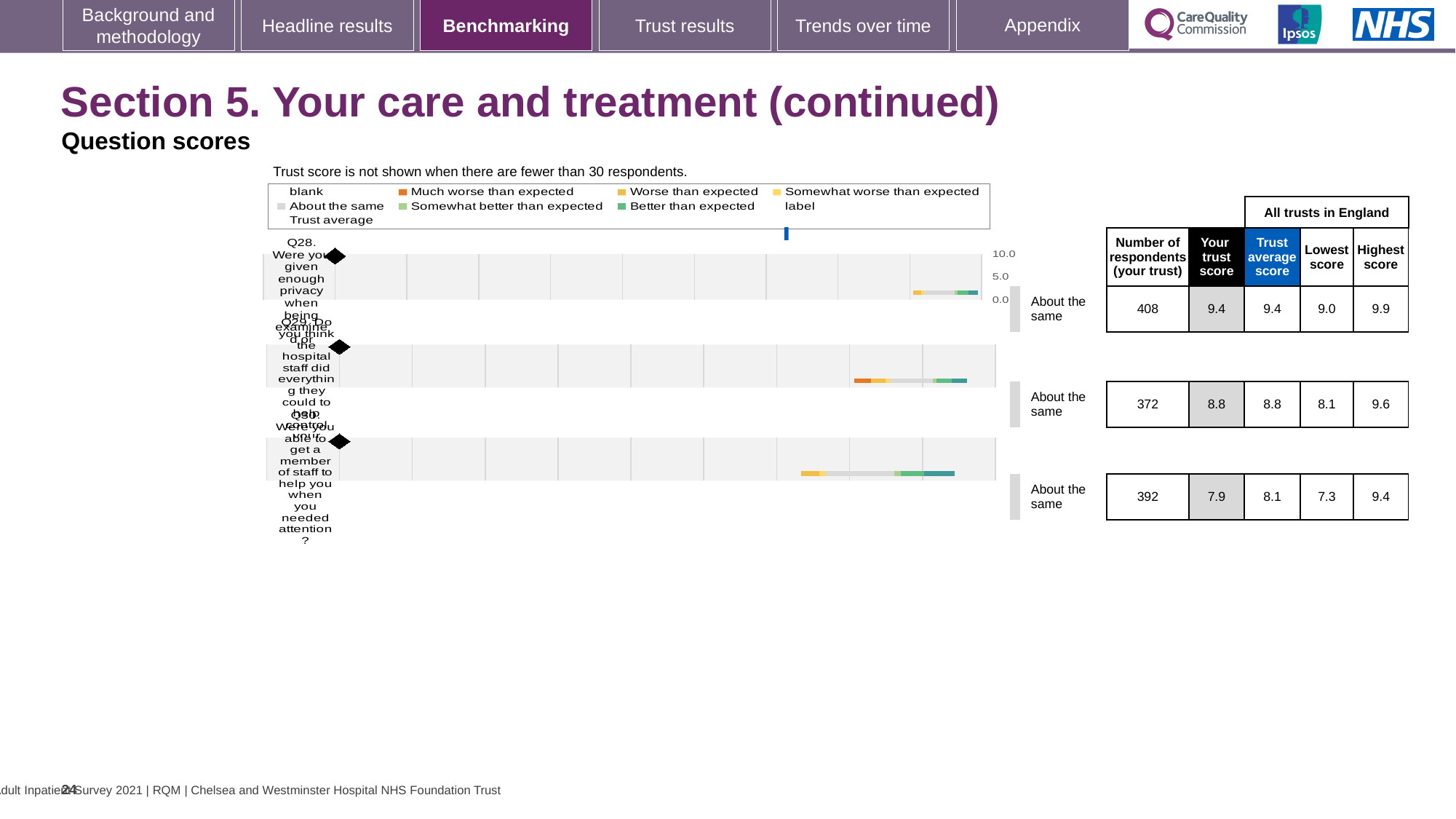
How many questions (categories) are plotted in the question scores chart? 3 What kind of chart is used to show the question scores on this slide? bar chart For Q30, which is larger: the trust score or the trust average score? Trust average score What benchmark category is shown next to each of the three questions? About the same What is the number of respondents for Q29 (Do you think the hospital staff did everything they could to help control your pain)? 372 Which question has the highest 'Your trust score'? Q28 What is the highest score across all trusts in England for Q30? 9.4 What is the lowest score across all trusts in England for Q29? 8.1 What is the 'Your trust score' value for Q30 (Were you able to get a member of staff to help you when you needed attention)? 7.9 What is the difference between the highest score and the lowest score for Q28? 0.9 What is the 'Your trust score' value for Q28 (Were you given enough privacy when being examined or treated)? 9.4 Which question has the lowest 'Your trust score'? Q30